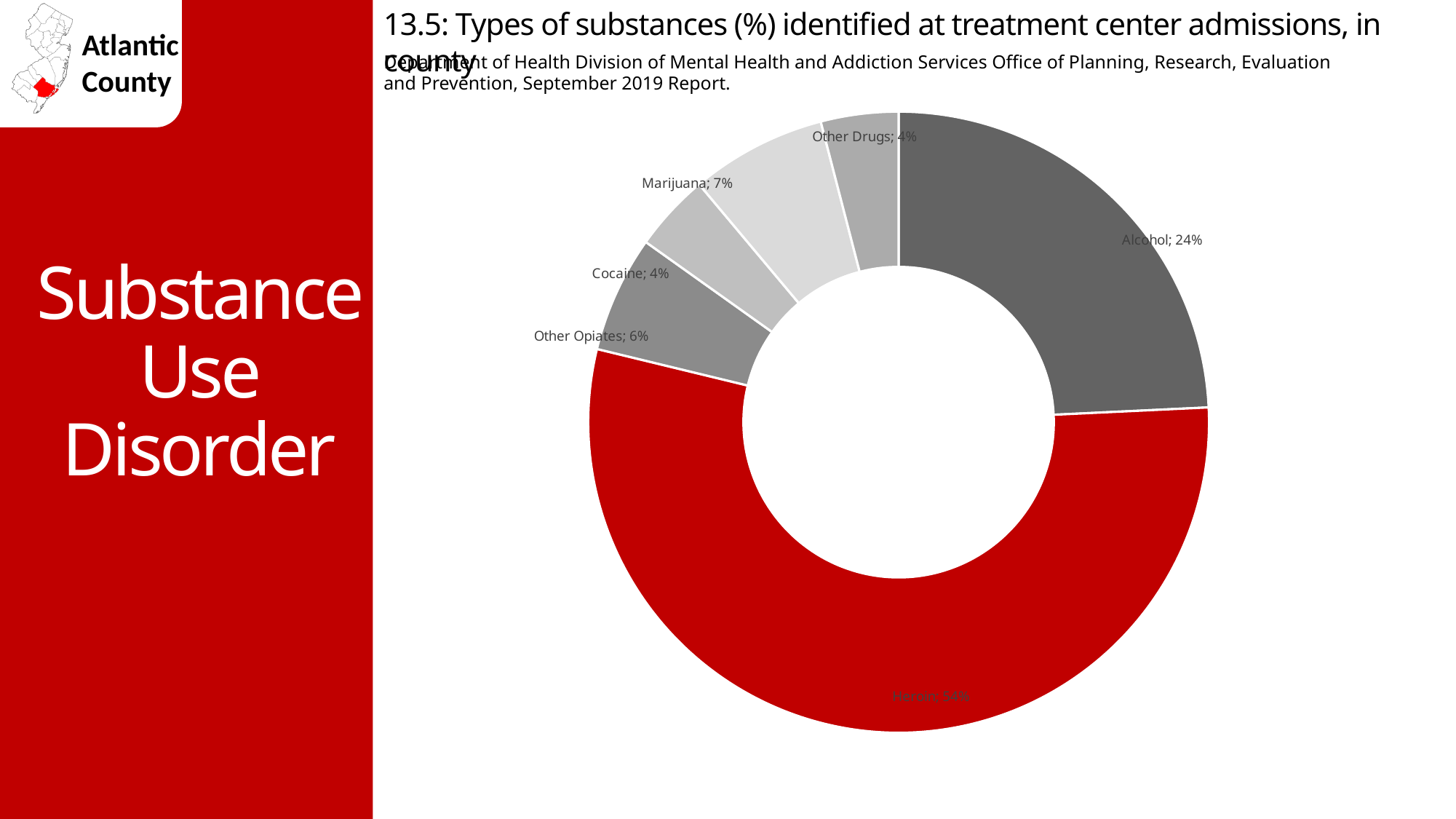
What is the combined percentage of Cocaine and Other Drugs? 8% What kind of chart is used on this slide? Doughnut (pie) chart Which substance has the largest share of treatment center admissions? Heroin How many substance categories are shown in the chart? 6 Which slice of the chart is coloured red? Heroin What percentage is shown for Other Opiates? 6% What percentage is shown for Marijuana? 7% What percentage of treatment center admissions is attributed to Alcohol? 24% What percentage is shown for Cocaine? 4% What is the difference in percentage points between Heroin and Alcohol? 30 What percentage of treatment center admissions is attributed to Heroin? 54% Which has a larger share, Marijuana or Other Opiates? Marijuana